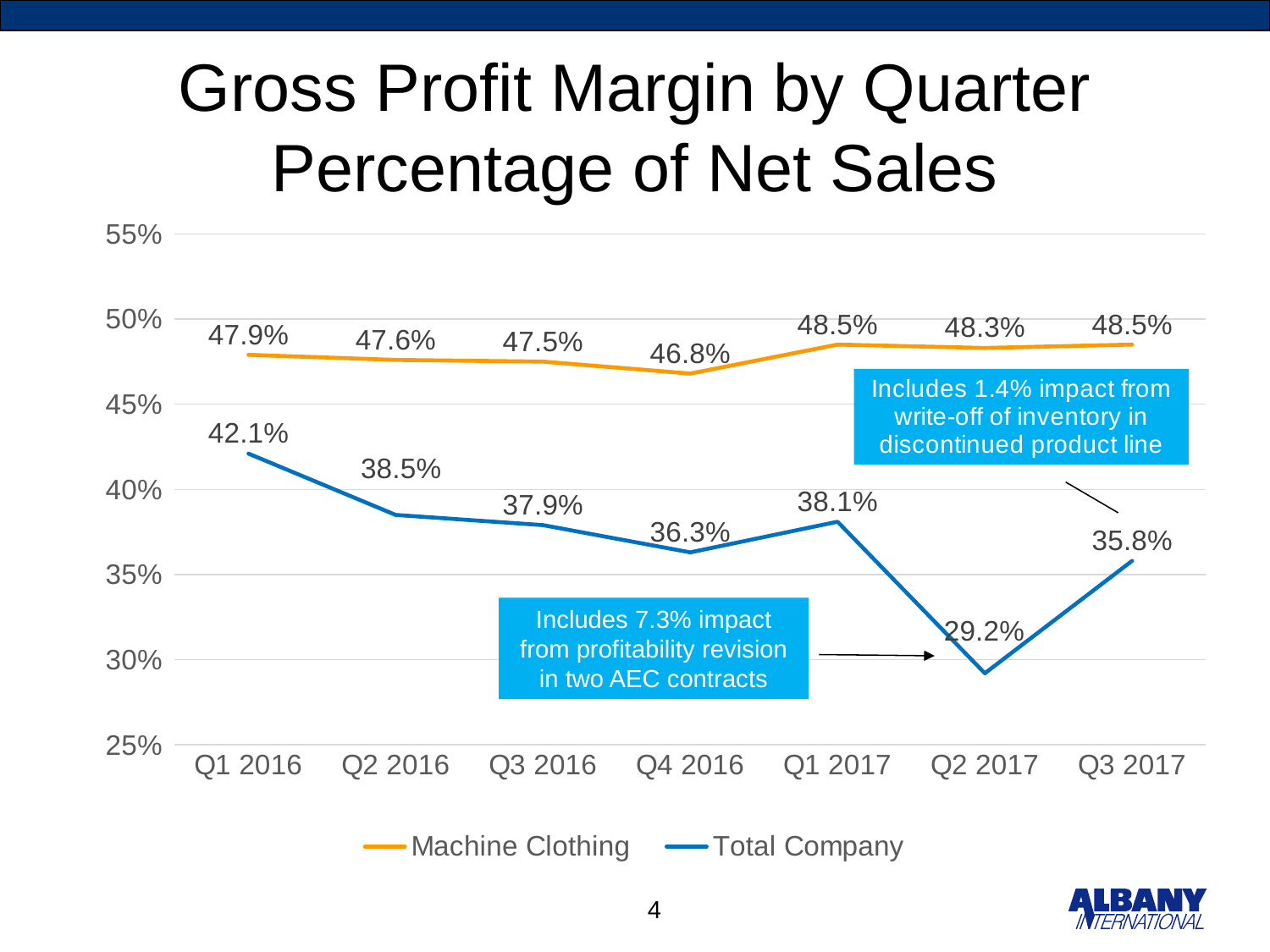
What kind of chart is shown on the slide? Line chart What is the Total Company gross profit margin in Q1 2016? 42.1% In which quarter is the Machine Clothing gross profit margin lowest? Q4 2016 Is the Total Company margin in Q2 2017 greater or less than 30%? less How many series does the legend list? 2 What is the Machine Clothing gross profit margin in Q4 2016? 46.8% What is the difference between the Machine Clothing and Total Company margins in Q2 2017? 19.1% What is the Total Company gross profit margin in Q2 2017? 29.2% How many quarters are shown on the x axis? 7 Which is larger in Q3 2017: the Machine Clothing margin or the Total Company margin? Machine Clothing In which quarter is the Total Company gross profit margin lowest? Q2 2017 Does the Total Company margin rise or fall from Q1 2016 to Q4 2016? Fall